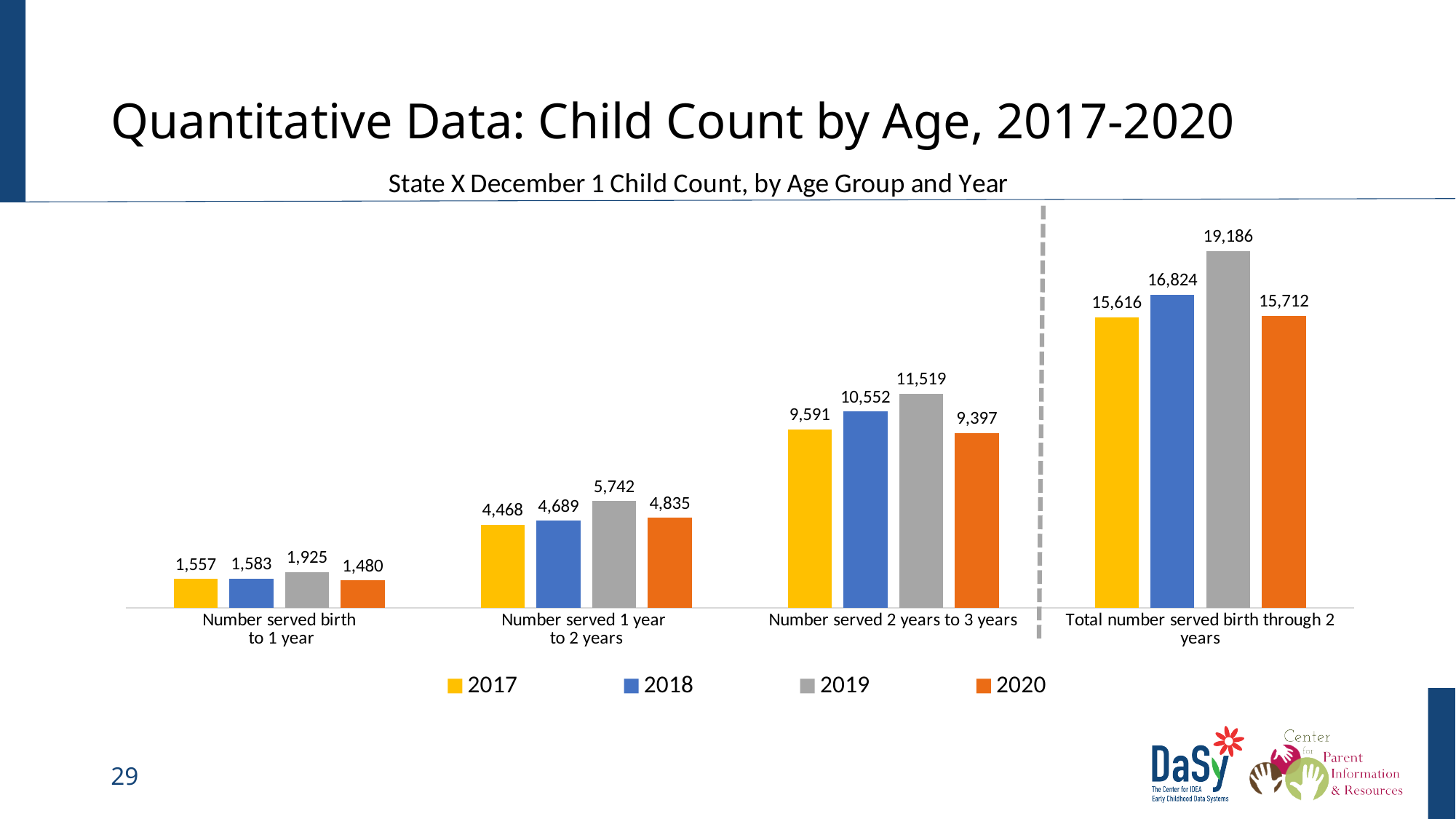
What is the title of the chart? State X December 1 Child Count, by Age Group and Year What is the number served birth to 1 year in 2019? 1,925 What kind of chart is shown on the slide? bar chart What is the number served 2 years to 3 years in 2020? 9,397 What is the difference between the 2019 and 2018 values for number served 1 year to 2 years? 1,053 How many age-group categories are shown on the x axis? 4 Which year has the highest total number served birth through 2 years? 2019 Which year has the lowest number served birth to 1 year? 2020 Which colour represents 2019 in the legend? gray What is the total number served birth through 2 years in 2018? 16,824 How many series does the legend list? 4 Which is larger: the 2017 or the 2020 value for number served 1 year to 2 years? 2020